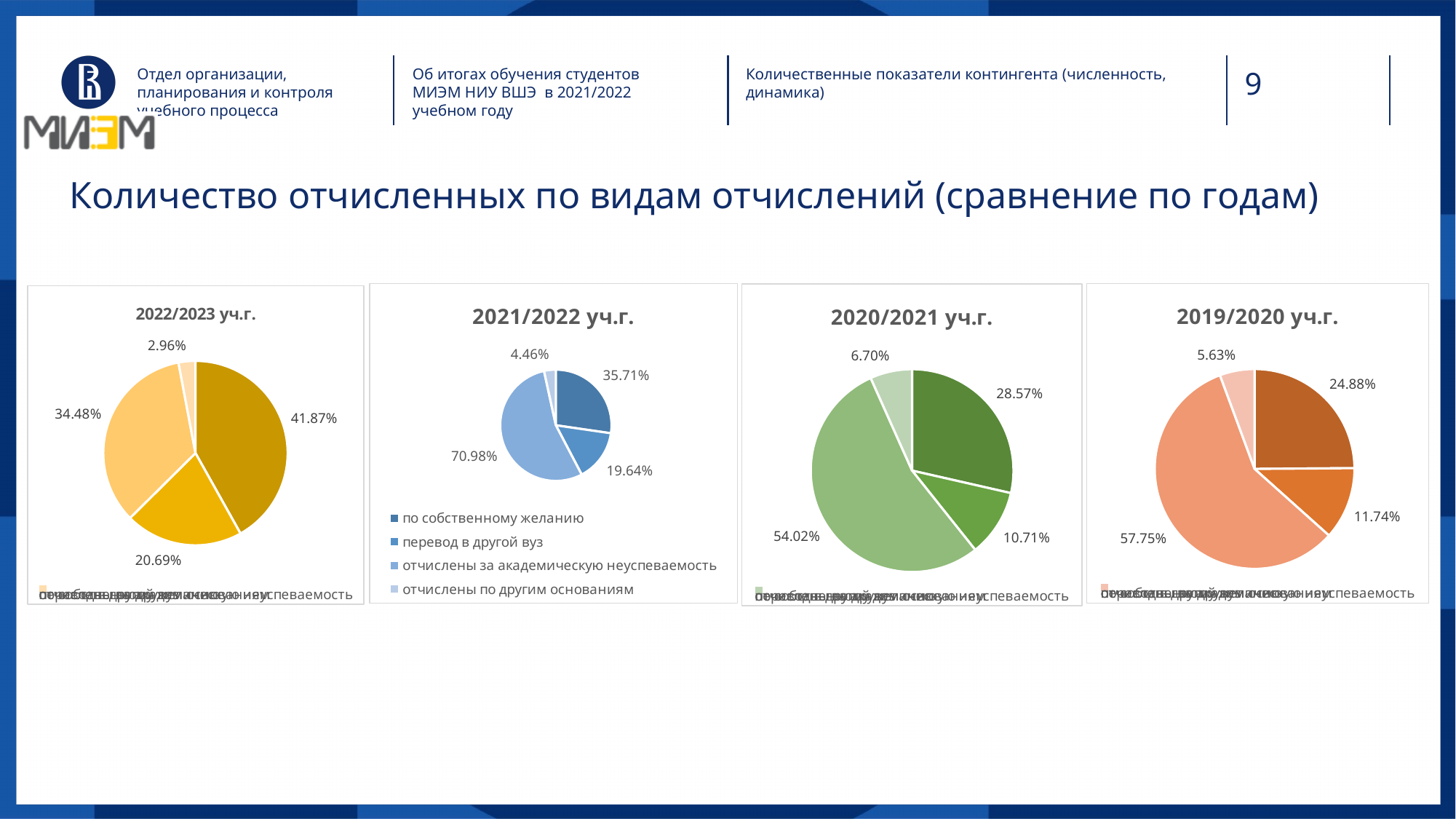
Which chart has the larger largest slice: 2020/2021 уч.г. or 2019/2020 уч.г.? 2019/2020 уч.г. In the 2021/2022 уч.г. chart, how many entries does the legend list? 4 In the 2019/2020 уч.г. chart, what is the value of the smallest slice? 5.63% What kind of charts are shown on the slide? Pie charts In the 2020/2021 уч.г. chart, what is the value of the largest slice? 54.02% How many pie charts are on the slide? 4 In the 2021/2022 уч.г. chart, what is the value for 'по собственному желанию'? 35.71% In the 2021/2022 уч.г. chart, what is the value for 'отчислены по другим основаниям'? 4.46% In the 2022/2023 уч.г. chart, what is the difference between the 41.87% slice and the 34.48% slice? 7.39% In the 2022/2023 уч.г. chart, what is the value of the smallest slice? 2.96% In the 2022/2023 уч.г. chart, what is the value of the largest slice? 41.87% In the 2022/2023 уч.г. chart, how many slices does the pie have? 4